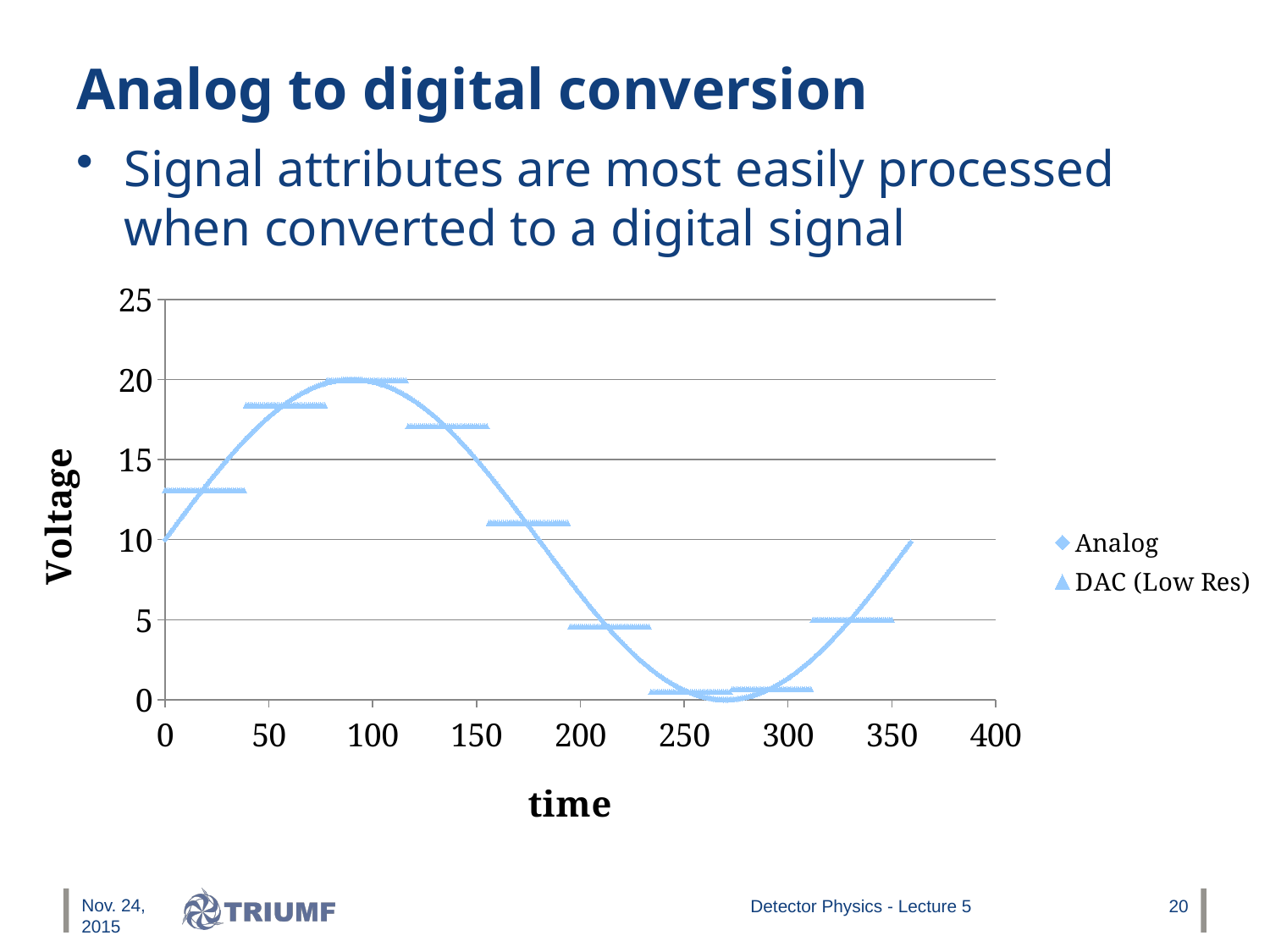
How many series does the chart legend list? 2 Is the DAC (Low Res) value at time 150 greater or less than 15? greater Between time 100 and time 250, does the Analog series rise or fall? fall Is the Analog value at time 300 greater or less than 5? less Which is larger: the DAC (Low Res) value at time 100 or at time 300? time 100 What kind of chart is shown on the slide? scatter chart What is the peak value reached by the Analog series? 20 What is the title of the vertical axis of the chart? Voltage What is the Analog value at time 0? 10 What is the lowest value reached by the Analog series? 0 Is the Analog value at time 50 greater or less than 15? greater What are the names of the two series in the chart legend? Analog and DAC (Low Res)